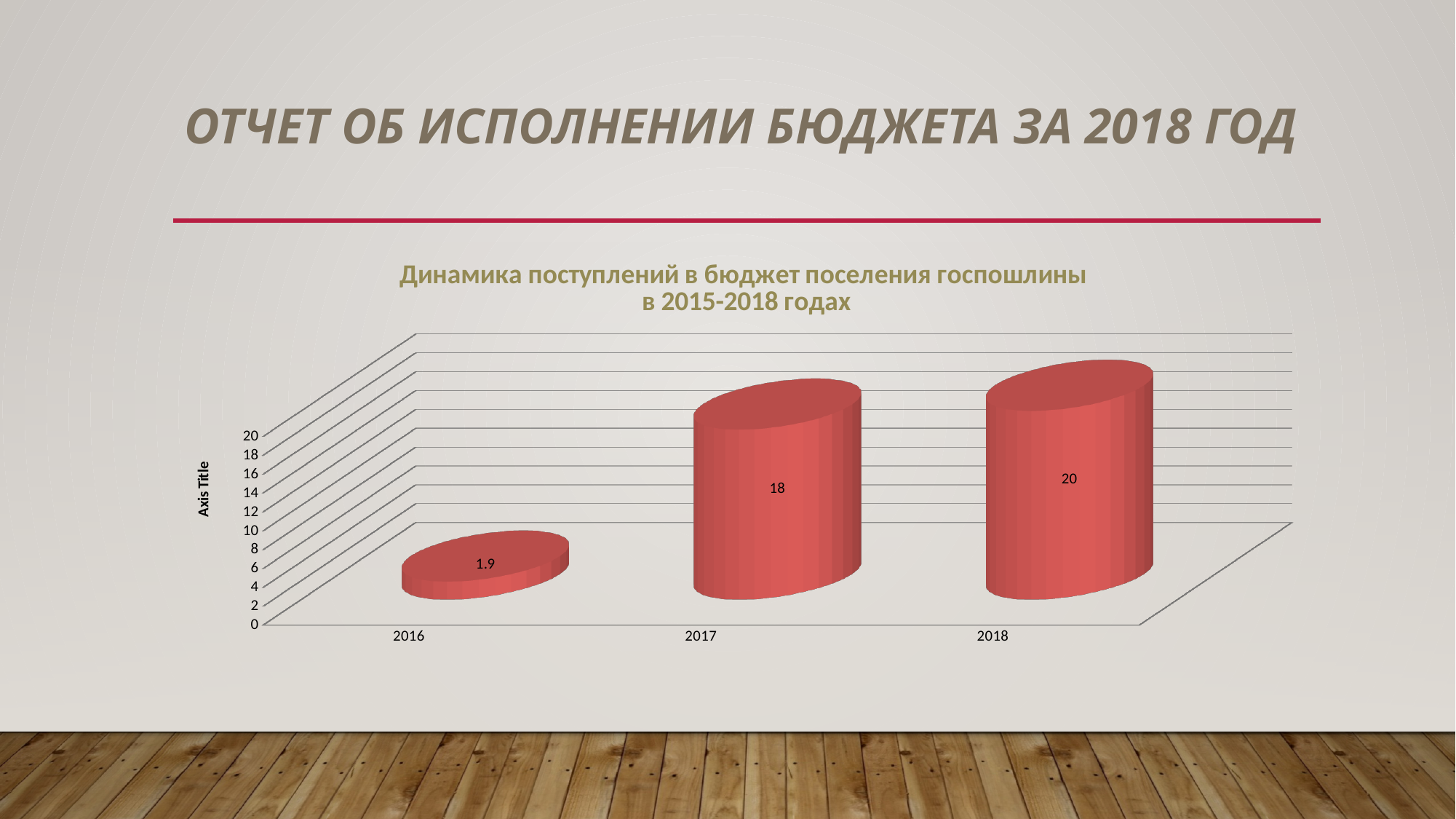
Do the values rise or fall from 2016 to 2018? rise What is the difference between the values for 2018 and 2017? 2 What is the value for 2017? 18 What kind of chart is shown on the slide? bar chart What is the value for 2018? 20 Which year has the lowest value? 2016 What is the title of the chart? Динамика поступлений в бюджет поселения госпошлины в 2015-2018 годах What is the difference between the values for 2017 and 2016? 16.1 Which year has the highest value? 2018 Which is larger, the value for 2016 or the value for 2017? 2017 How many years are shown on the x axis? 3 What is the value for 2016? 1.9